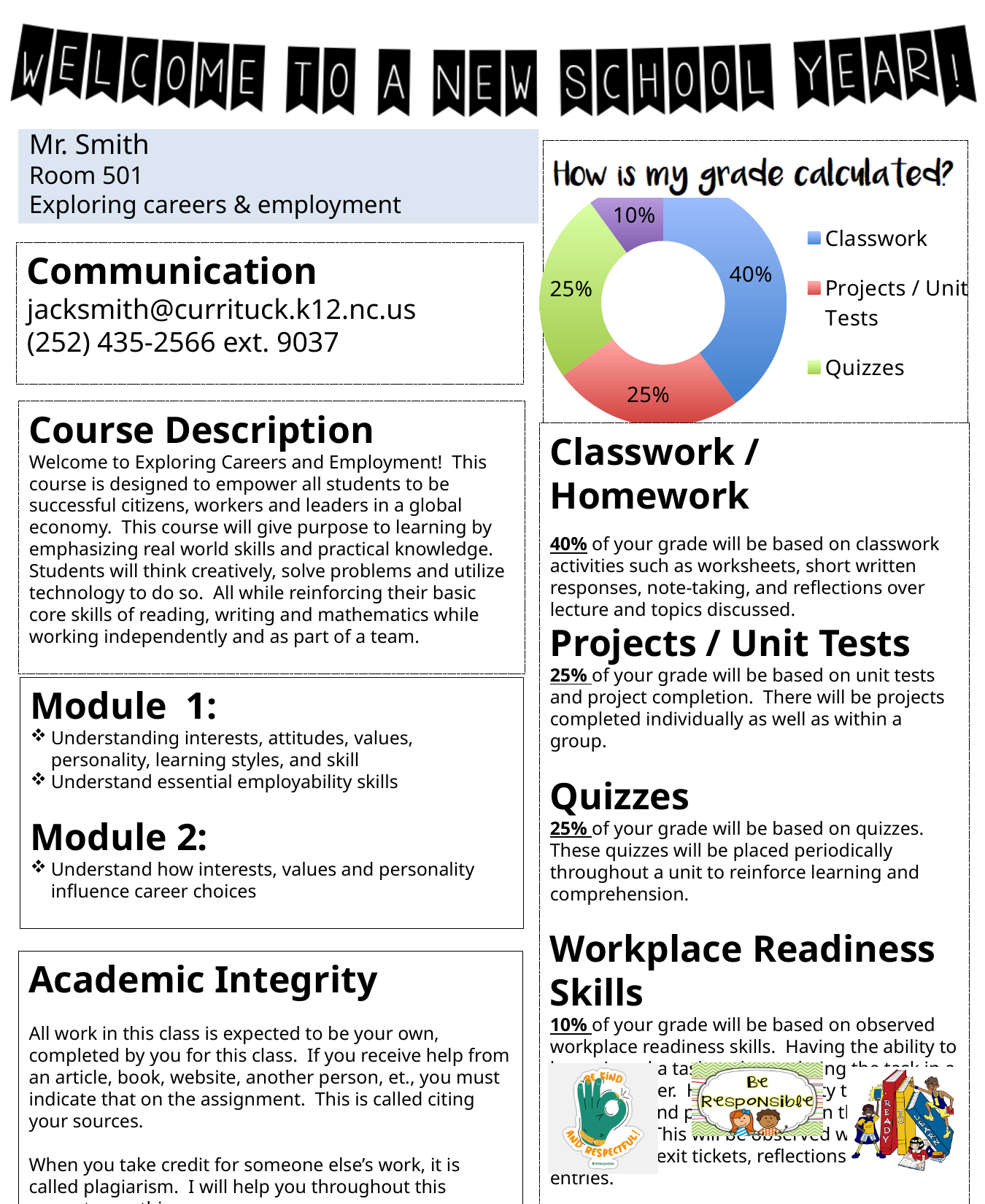
By how many percentage points does Classwork exceed Quizzes in the chart? 15% What is the title of the chart on the slide? How is my grade calculated? How many slices does the doughnut chart have? 4 Which category has the largest share in the grade chart? Classwork What is the smallest percentage labelled on the grade chart? 10% What colour represents Classwork in the chart? blue Which is larger in the chart, Classwork or Projects / Unit Tests? Classwork What percentage of the grade does Classwork account for in the chart? 40% How many entries does the legend of the grade chart list? 3 What percentage does the Projects / Unit Tests slice show in the chart? 25% What type of chart is shown under "How is my grade calculated?"? doughnut chart What percentage does the Quizzes slice show in the chart? 25%